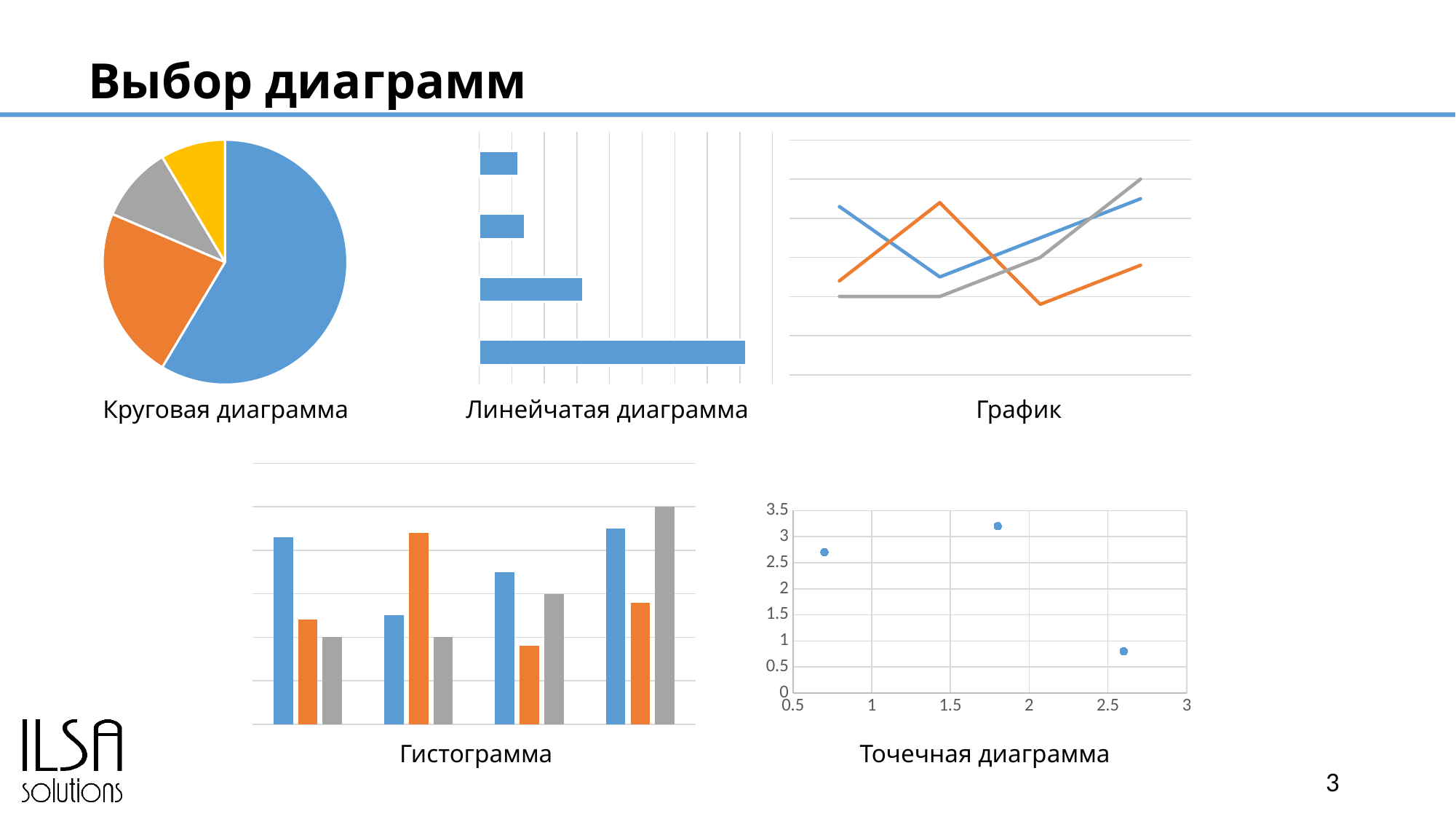
What kind of chart is the one captioned "График"? line chart What kind of chart is the one captioned "Точечная диаграмма"? scatter chart In the scatter chart captioned "Точечная диаграмма", is the y value of the point near x = 2.6 greater or less than 1? less In the pie chart (top left), which colour slice is the largest? blue In the scatter chart captioned "Точечная диаграмма", how many points are plotted? 3 What kind of chart is the one captioned "Линейчатая диаграмма"? bar chart In the pie chart (top left), how many slices are there? 4 In the line chart captioned "График", how many lines are plotted? 3 In the scatter chart captioned "Точечная диаграмма", is the y value of the point near x = 1.8 greater or less than 3? greater